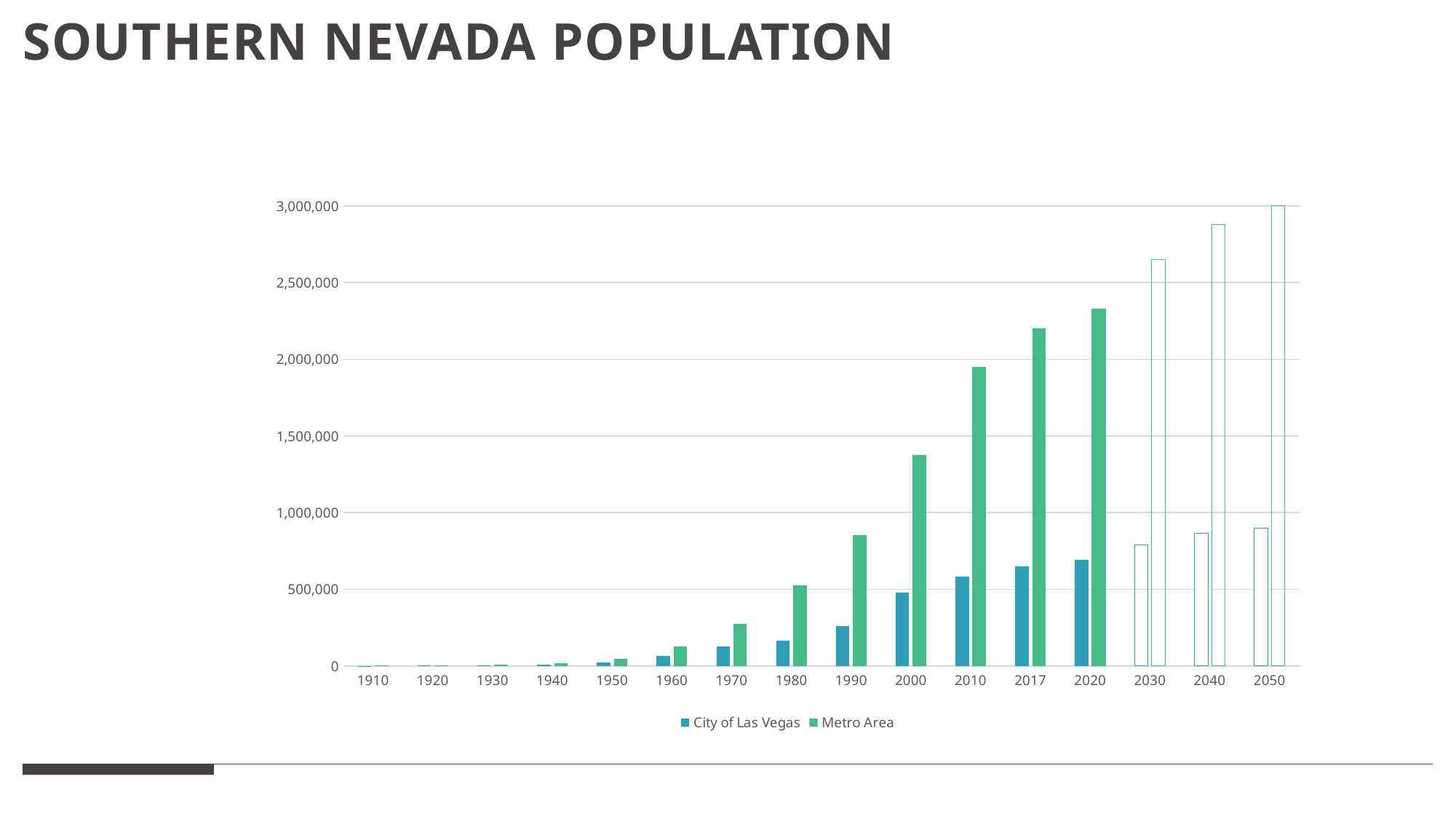
Which year has the highest Metro Area value? 2050 Which is larger in 2010, the City of Las Vegas value or the Metro Area value? Metro Area Do the Metro Area values rise or fall from 1910 to 2050? rise Is the City of Las Vegas value for 2020 greater or less than 500,000? greater What kind of chart is shown on the slide? bar chart What is the title of the chart? SOUTHERN NEVADA POPULATION Is the Metro Area value for 2040 greater or less than 2,500,000? greater How many series does the legend list? 2 Which year has the lowest Metro Area value? 1910 Is the Metro Area value for 2020 greater or less than 2,500,000? less How many years are shown along the x axis? 16